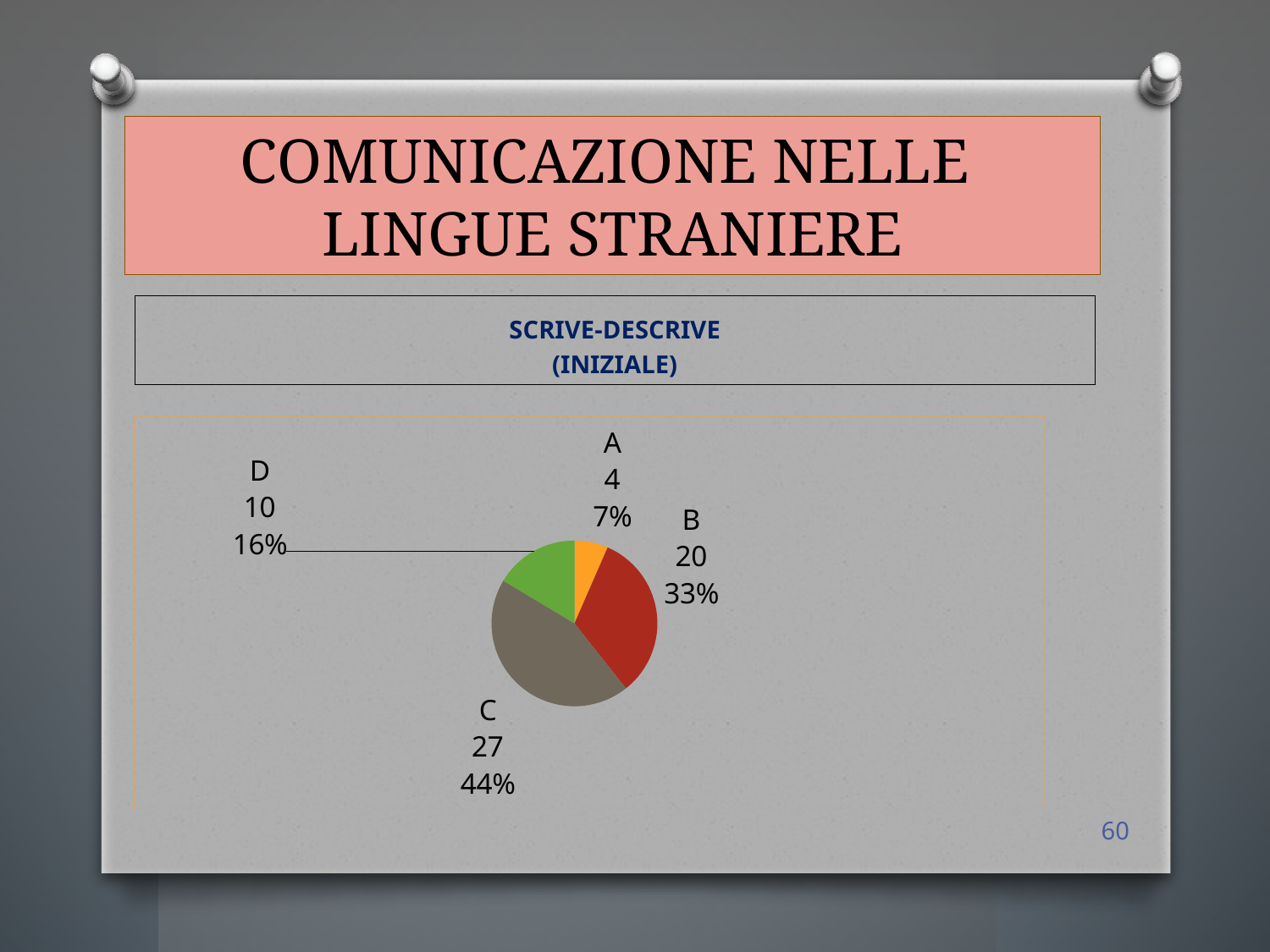
What is the value for category A? 4 What is the difference between the values for C and B? 7 Which category has the smallest slice? A What is the value for category C? 27 What percentage share does category D have? 16% What is the total of all the values in the pie chart? 61 How many slices does the pie chart have? 4 What is the title of the chart? SCRIVE-DESCRIVE (INIZIALE) What percentage share does category B have? 33% What type of chart is shown on the slide? pie chart Which category has the largest slice? C Which is larger, the value for B or the value for D? B